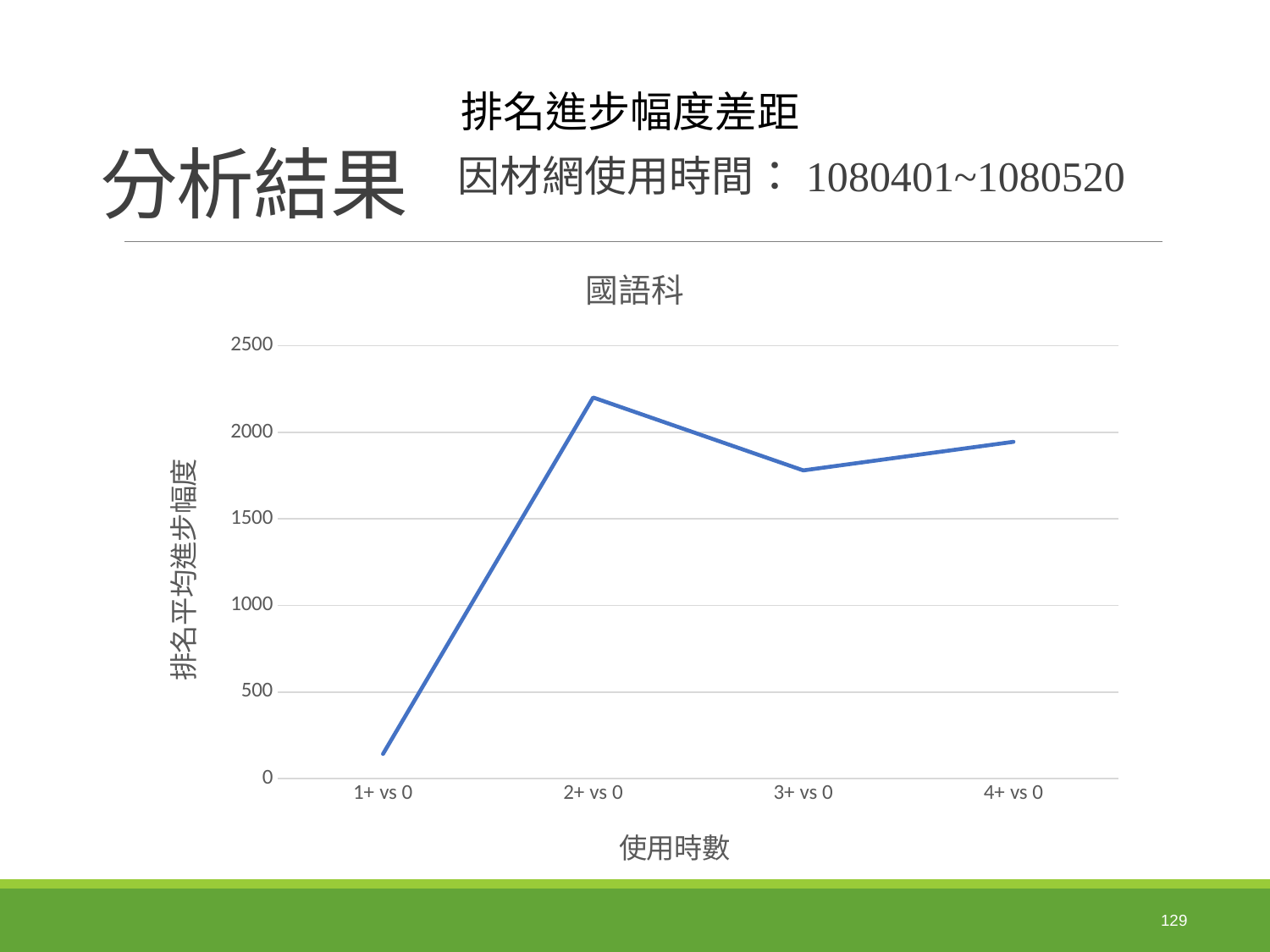
Does the line rise or fall from 1+ vs 0 to 2+ vs 0? rise Is the value for 4+ vs 0 greater or less than 1500? greater What is the title of the chart? 國語科 Which is larger, the value for 2+ vs 0 or the value for 3+ vs 0? 2+ vs 0 Which category has the lowest value? 1+ vs 0 Which category has the highest value? 2+ vs 0 How many categories are plotted along the x axis? 4 What is the label of the x axis? 使用時數 Is the value for 3+ vs 0 greater or less than 2000? less Is the value for 2+ vs 0 greater or less than 2000? greater What kind of chart is shown on the slide? line chart